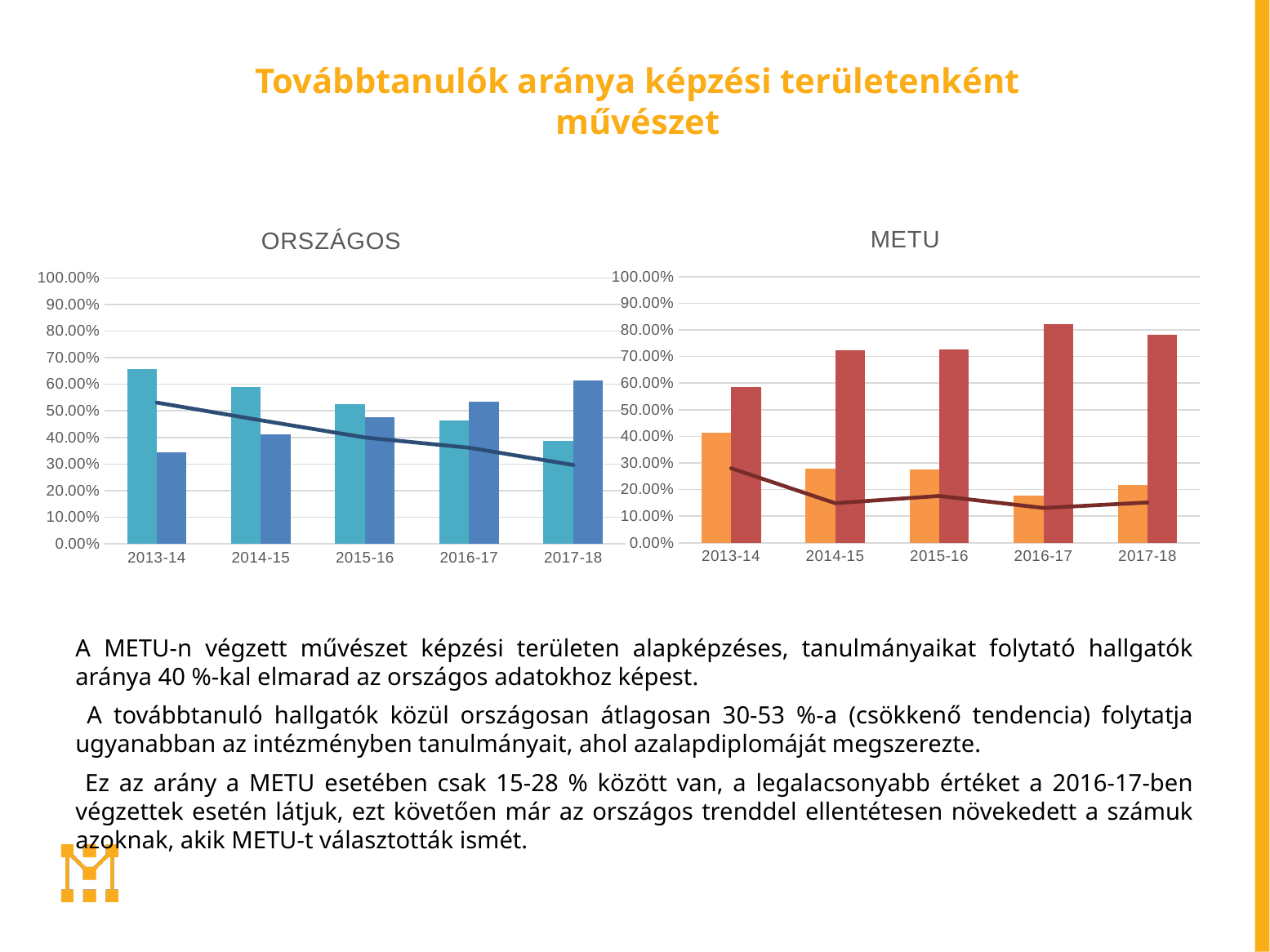
In the ORSZÁGOS chart, do the dark blue bars rise or fall from 2013-14 to 2017-18? rise In the METU chart, which is larger for 2014-15, the orange bar or the red bar? the red bar In the ORSZÁGOS chart, is the light blue bar for 2013-14 greater or less than 60.00%? greater In the METU chart, which year has the lowest orange bar? 2016-17 In the ORSZÁGOS chart, is the dark blue bar for 2013-14 greater or less than 40.00%? less In the ORSZÁGOS chart, do the light blue bars rise or fall from 2013-14 to 2017-18? fall What kind of chart is the ORSZÁGOS chart on the left? bar chart with a line In the METU chart, is the orange bar for 2013-14 greater or less than 50.00%? less In the ORSZÁGOS chart, which year has the highest light blue bar? 2013-14 In the METU chart, which year has the highest red bar? 2016-17 How many year categories are shown on the x axis of the METU chart? 5